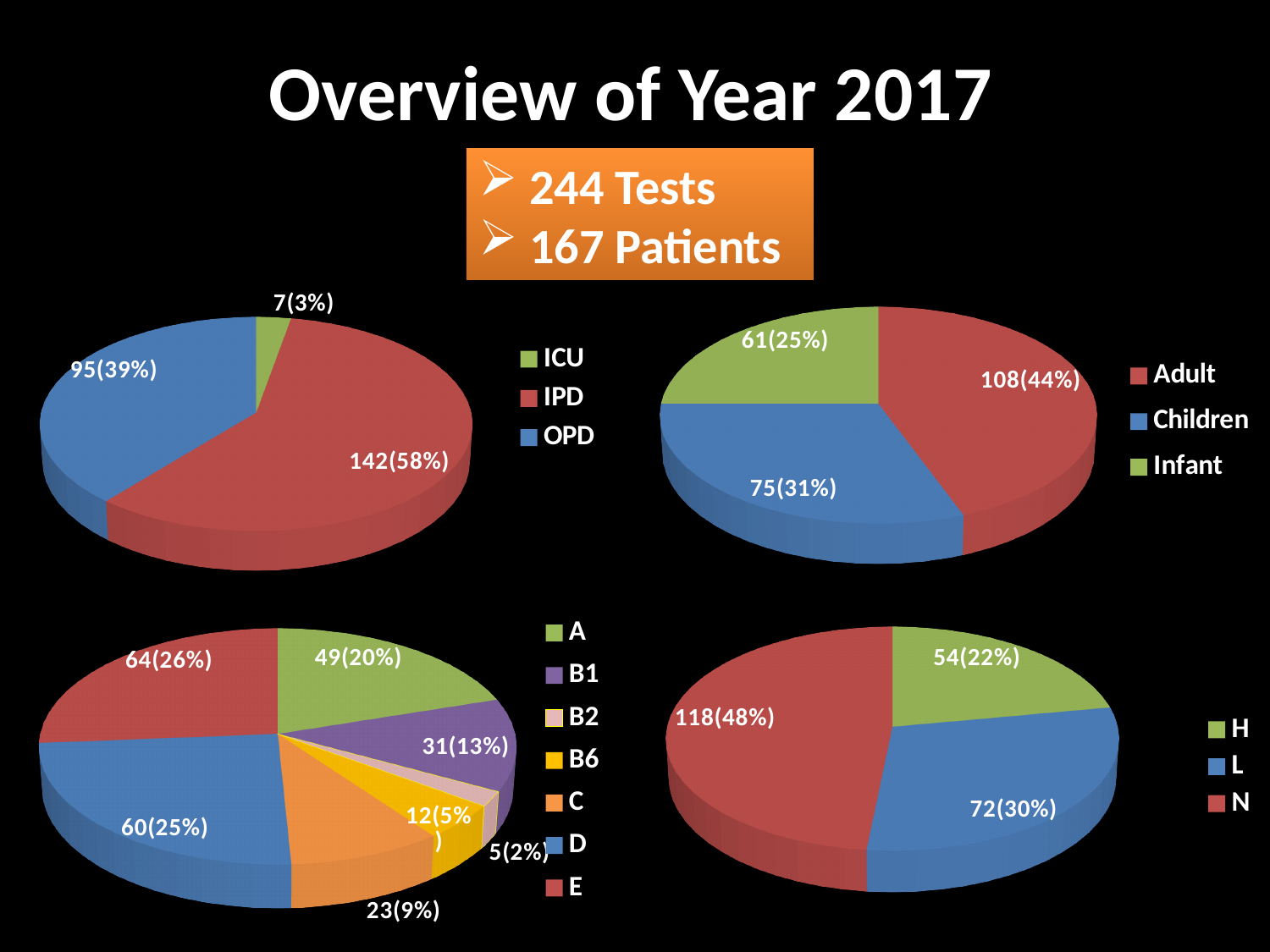
In the bottom-right pie chart, what share of the pie does N represent? 48% In the top-left pie chart, which category has the smallest slice? ICU In the bottom-left pie chart, which category has the largest slice? E In the top-right pie chart, which category has the largest slice? Adult In the top-right pie chart, what is the value shown for Children? 75(31%) What kind of chart is the top-left chart? Pie chart How many pie charts are shown on the slide? 4 In the top-right pie chart, what is the difference between the Adult count and the Infant count? 47 In the bottom-right pie chart, which is larger, H or L? L How many categories does the legend of the bottom-left pie chart list? 7 In the bottom-left pie chart, what is the value shown for B1? 31(13%) In the top-left pie chart, what is the value shown for IPD? 142(58%)